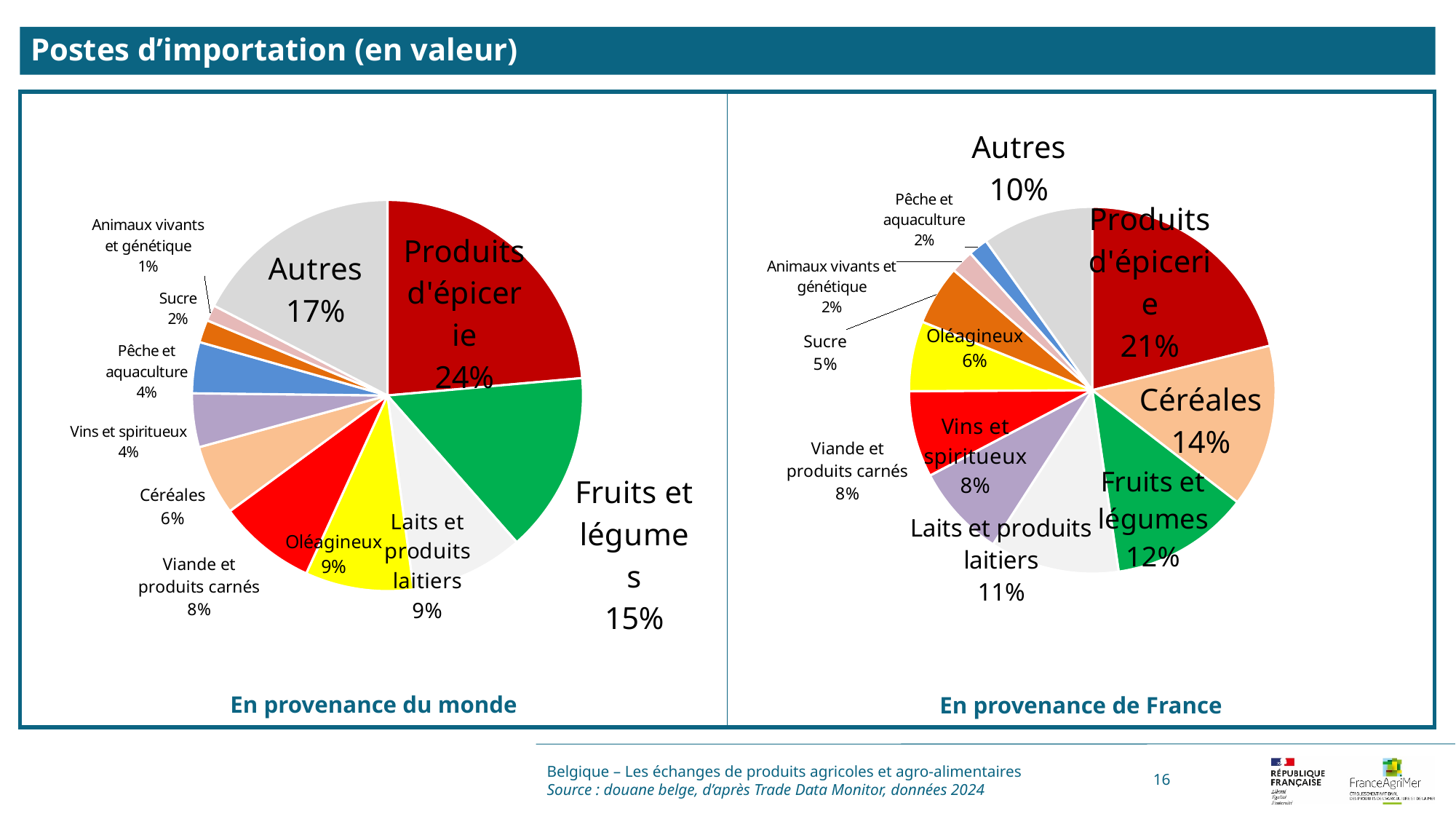
In the 'En provenance du monde' chart, what share do Produits d'épicerie represent? 24% In the 'En provenance du monde' chart, which category has the smallest share? Animaux vivants et génétique What type of chart is used on this slide? Pie chart In the 'En provenance du monde' chart, which named category (excluding Autres) has the largest share? Produits d'épicerie In the 'En provenance de France' chart, what is the share of Sucre? 5% In the 'En provenance de France' chart, which is larger: Fruits et légumes or Laits et produits laitiers? Fruits et légumes In the 'En provenance de France' chart, what share do Céréales represent? 14% In the 'En provenance de France' chart, which named category (excluding Autres) has the largest share? Produits d'épicerie How many slices does the 'En provenance du monde' pie chart have? 11 What is the difference between the share of Céréales in the 'En provenance de France' chart and in the 'En provenance du monde' chart? 8 percentage points In the 'En provenance du monde' chart, what is the share of Fruits et légumes? 15% What is the title of the slide? Postes d'importation (en valeur)